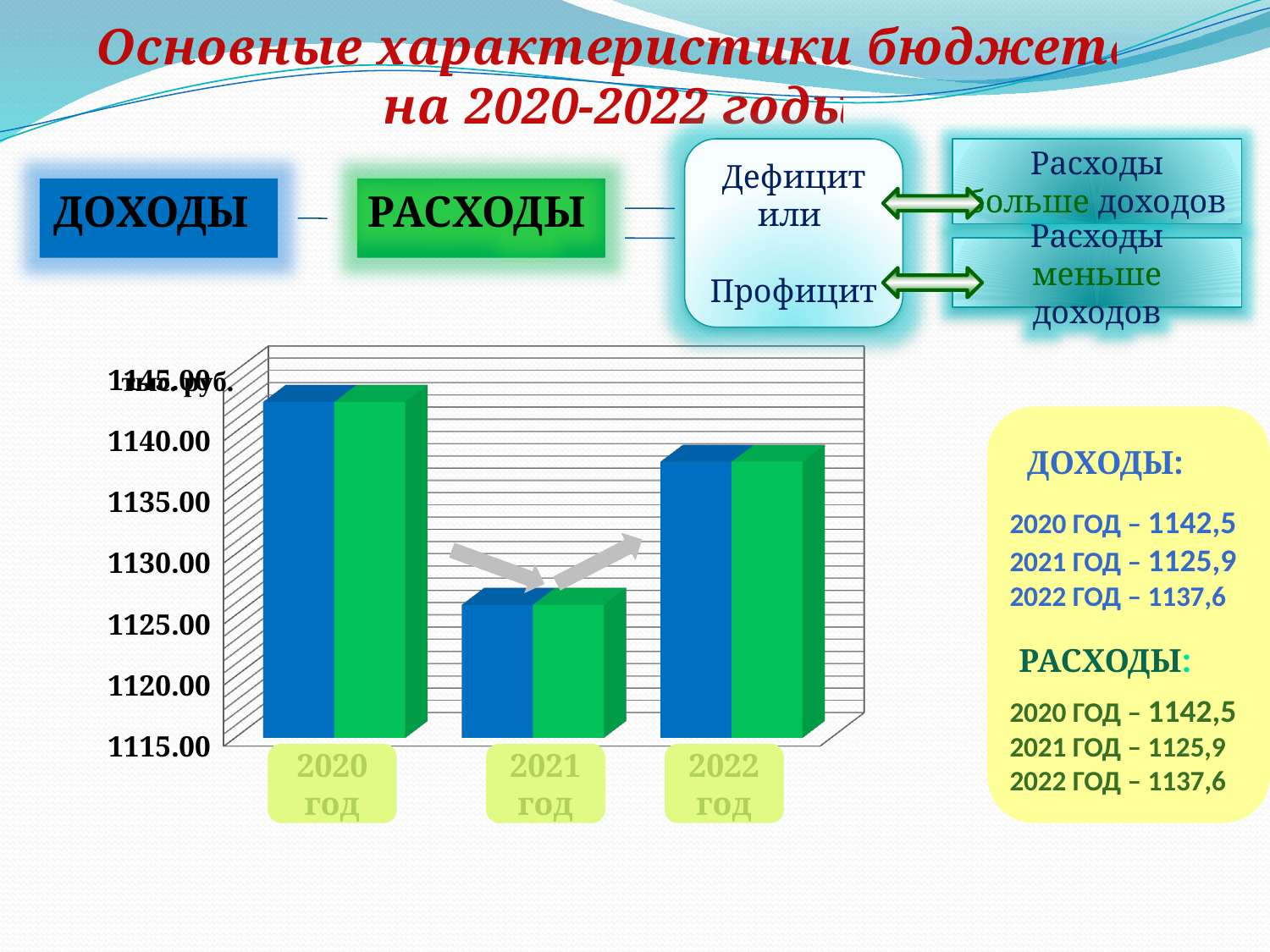
Is the value for 2020 год greater or less than 1140.00? greater Which year has a larger value, 2021 год or 2022 год? 2022 год Which year has the lowest bars in the chart? 2021 год Is the value for 2021 год greater or less than 1130.00? less What unit is written at the top of the chart's vertical axis? тыс. руб. Which year has the highest bars in the chart? 2020 год Do the values rise or fall from 2020 год to 2021 год? fall According to the slide, what is the value of ДОХОДЫ for 2020 год? 1142,5 According to the values printed on the slide, what is the difference between ДОХОДЫ for 2020 год and 2021 год? 16,6 What kind of chart is shown on the slide? bar chart Is the value for 2022 год greater or less than 1135.00? greater How many years (categories) are shown on the x axis of the chart? 3